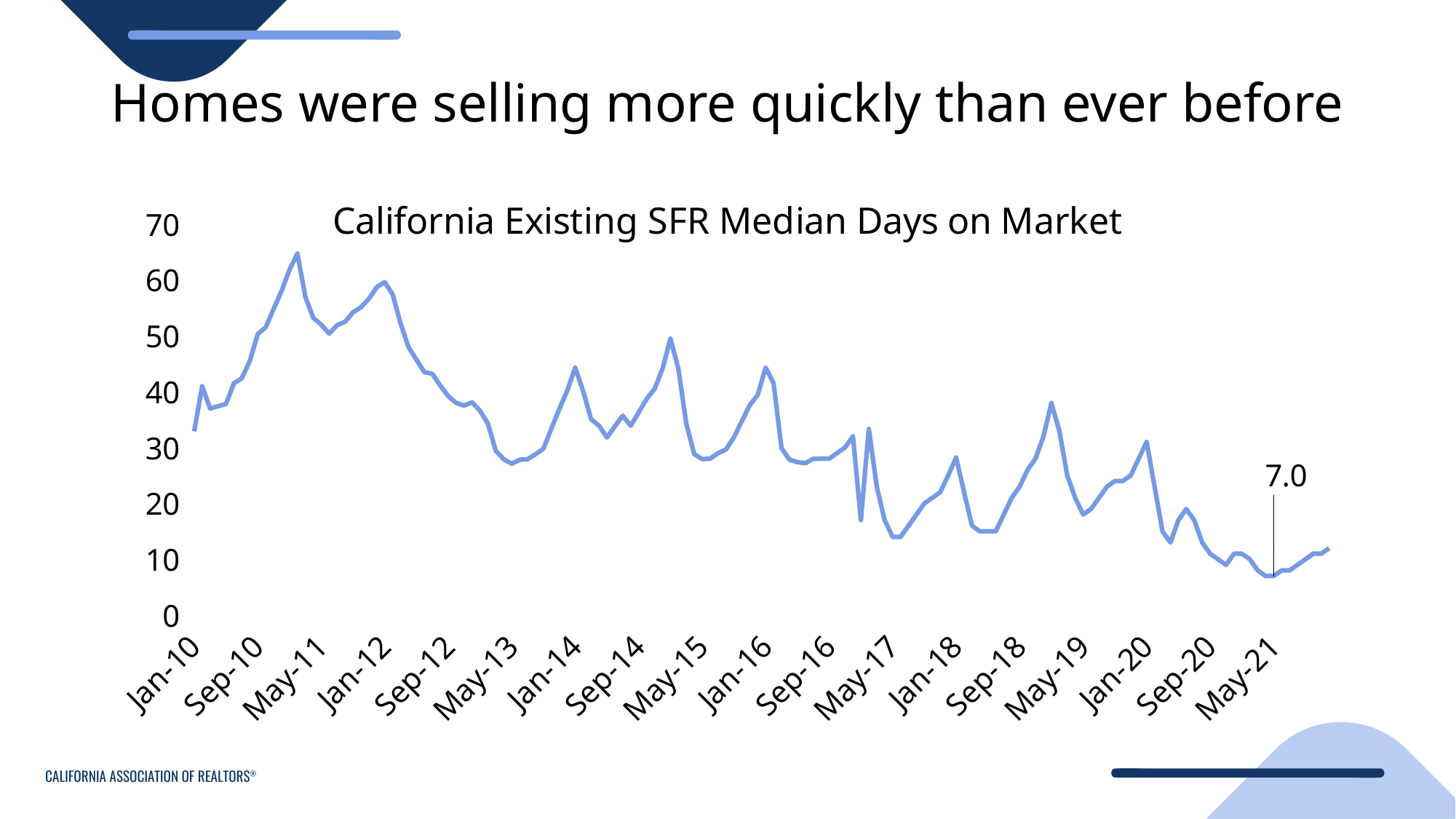
Is the value for May-21 greater or less than 20? less How many lines are plotted on the chart? 1 Overall, do the values rise or fall from Jan-10 to May-21? fall Is the value for Jan-18 greater or less than 40? less How many date labels are shown on the x axis? 18 What is the title of the chart? California Existing SFR Median Days on Market What kind of chart is shown on the slide? line chart What is the value shown by the data label at the lowest point of the line? 7.0 Is the value for Jan-10 greater or less than 20? greater What is the lowest value labeled on the chart? 7.0 Which is larger, the value for Jan-12 or the value for Jan-20? Jan-12